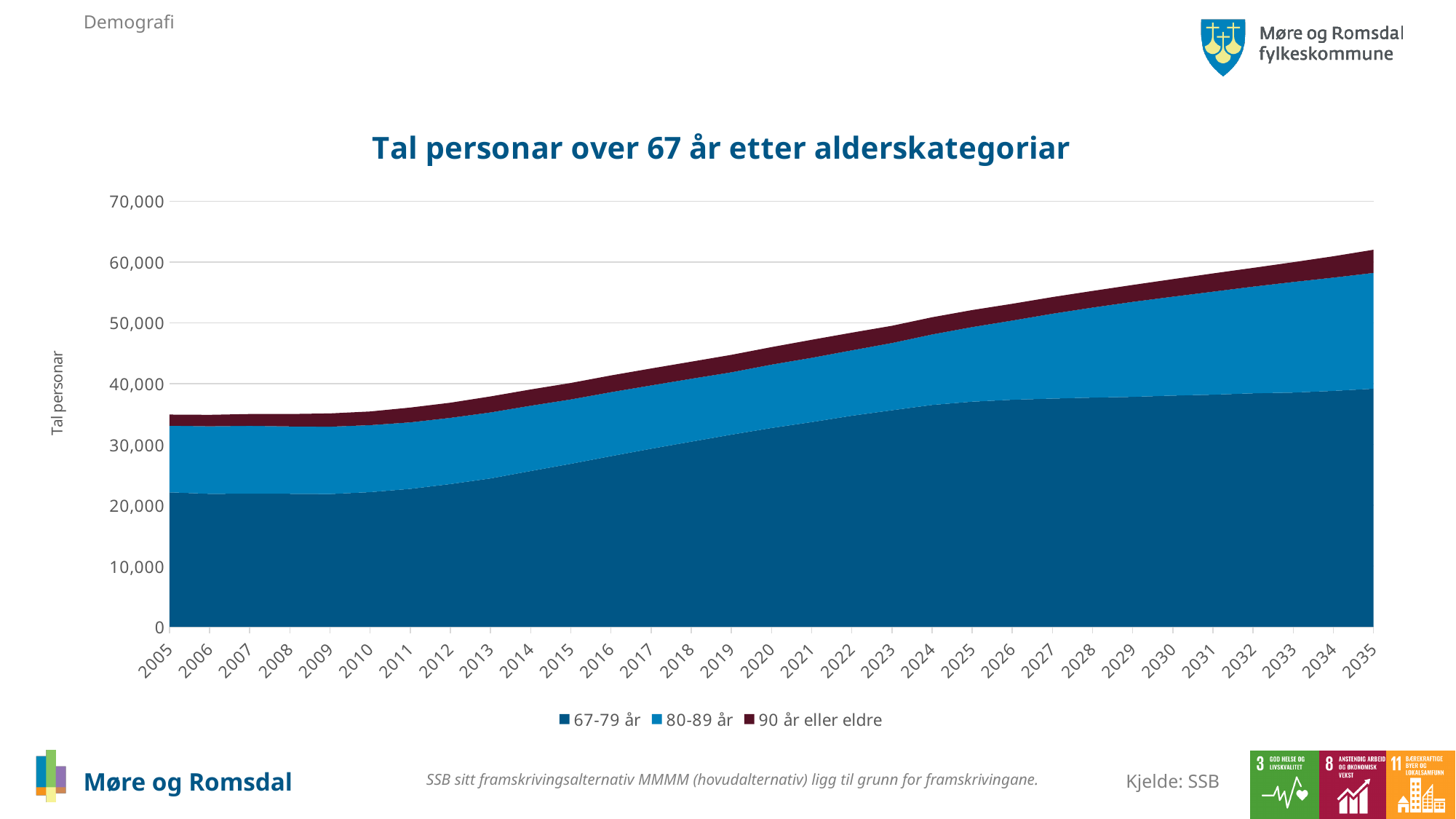
Is the total value for 2005 greater or less than 40,000? less How many series does the legend list? 3 What kind of chart is shown on the slide? Stacked area chart What is the title of the chart? Tal personar over 67 år etter alderskategoriar Is the value for 67-79 år in 2005 greater or less than 20,000? greater In 2035, which series is larger: 67-79 år or 80-89 år? 67-79 år How many years are shown along the x axis? 31 Is the value for 67-79 år in 2035 greater or less than 30,000? greater Does the total number of persons over 67 rise or fall from 2005 to 2035? Rise What is the label on the vertical axis? Tal personar Which age category has the largest values throughout the chart? 67-79 år